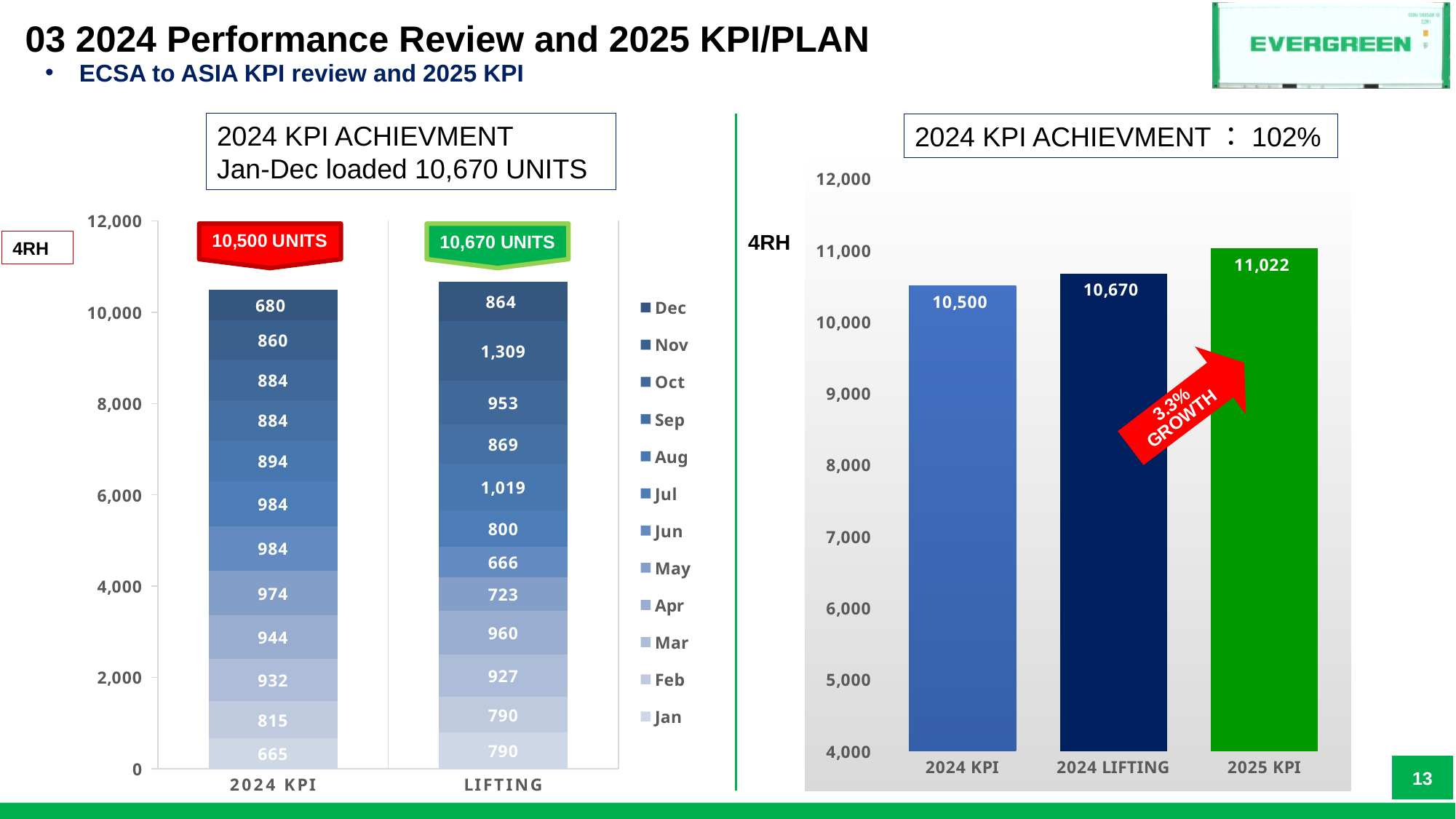
In the right bar chart, what is the value for 2025 KPI? 11,022 In the left stacked bar chart, what is the total of the LIFTING bar? 10,670 In the left stacked bar chart, what is the Dec value for the LIFTING bar? 864 In the left stacked bar chart, what is the Jan value for the 2024 KPI bar? 665 In the left stacked bar chart, what is the Nov value for the LIFTING bar? 1,309 In the right bar chart, how many bars are plotted? 3 In the left stacked bar chart, what is the difference between the Aug values of the LIFTING bar and the 2024 KPI bar? 125 In the right bar chart, what is the difference between 2025 KPI and 2024 KPI? 522 In the left stacked bar chart, which month has the largest segment in the LIFTING bar? Nov What type of chart is shown on the right side of the slide? Bar chart In the left stacked bar chart, how many series does the legend list? 12 In the right bar chart, which category has the lowest value? 2024 KPI